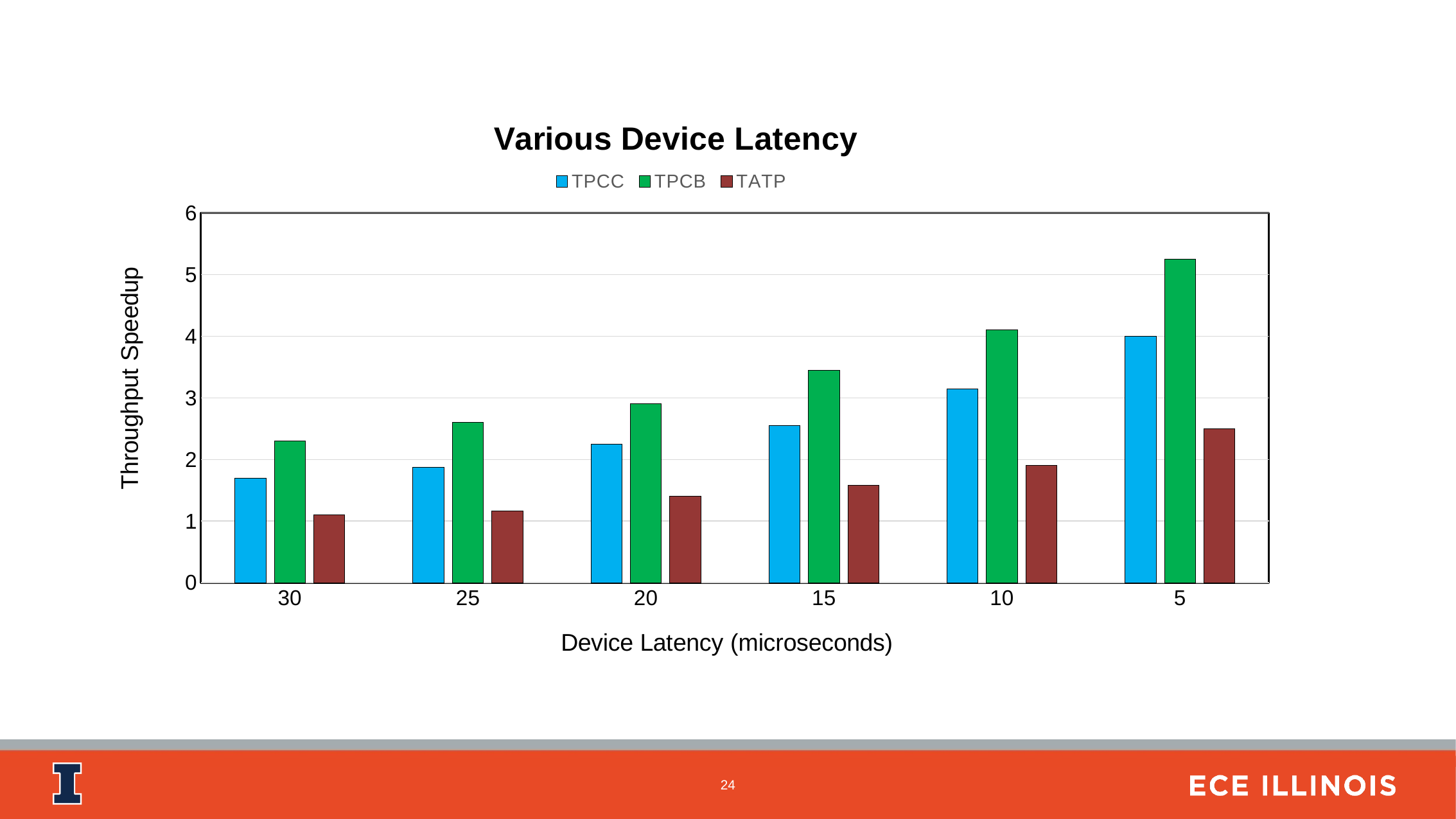
How many series does the legend list? 3 What kind of chart is shown on the slide? bar chart Which series has the highest throughput speedup at a device latency of 5 microseconds? TPCB Does the TPCC throughput speedup rise or fall as the device latency decreases from 30 to 5 microseconds along the x axis? rise At which device latency does TPCB reach its highest throughput speedup? 5 Which series has the lowest throughput speedup at a device latency of 30 microseconds? TATP Is the TATP throughput speedup at 30 microseconds greater or less than 2? less What is the title of the chart? Various Device Latency How many device latency categories are shown on the x axis? 6 Is the TPCC throughput speedup at 10 microseconds greater or less than 3? greater Is the TPCB throughput speedup at 5 microseconds greater or less than 5? greater Which is larger at 15 microseconds, the TPCC speedup or the TATP speedup? TPCC